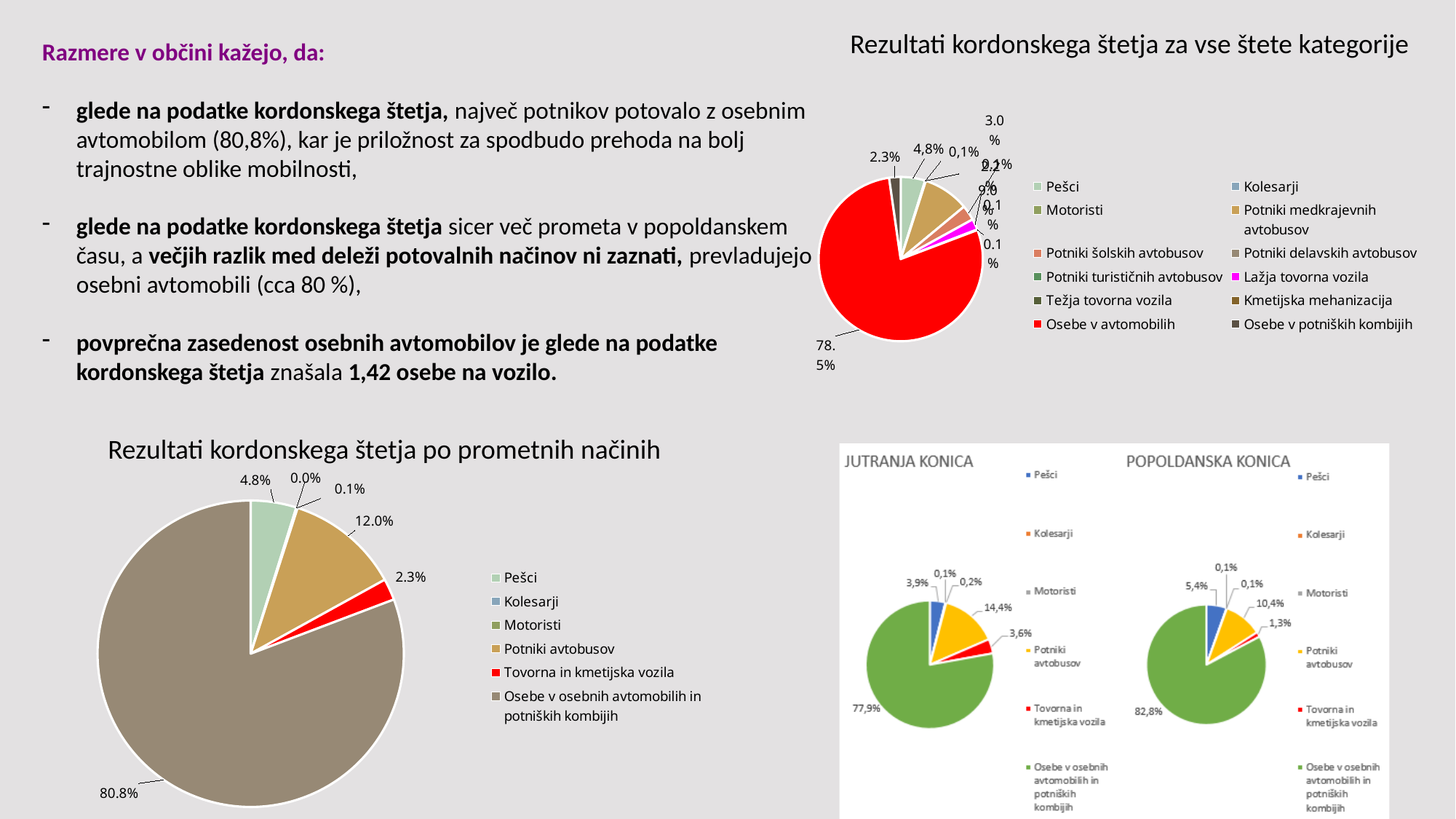
In the chart 'Rezultati kordonskega štetja po prometnih načinih', what share is shown for Potniki avtobusov? 12.0% Which is larger: the share for Pešci in the JUTRANJA KONICA chart or in the POPOLDANSKA KONICA chart? POPOLDANSKA KONICA In the POPOLDANSKA KONICA pie chart, what share is shown for Osebe v osebnih avtomobilih in potniških kombijih? 82,8% In the chart 'Rezultati kordonskega štetja po prometnih načinih', how many categories does the legend list? 6 In the chart 'Rezultati kordonskega štetja za vse štete kategorije', what share is shown for Osebe v avtomobilih? 78.5% In the chart 'Rezultati kordonskega štetja za vse štete kategorije', how many categories does the legend list? 12 What kind of chart is 'Rezultati kordonskega štetja za vse štete kategorije'? pie chart In the chart 'Rezultati kordonskega štetja po prometnih načinih', what is the difference between the shares for Potniki avtobusov and Tovorna in kmetijska vozila? 9.7% In the chart 'Rezultati kordonskega štetja po prometnih načinih', which category has the largest slice? Osebe v osebnih avtomobilih in potniških kombijih